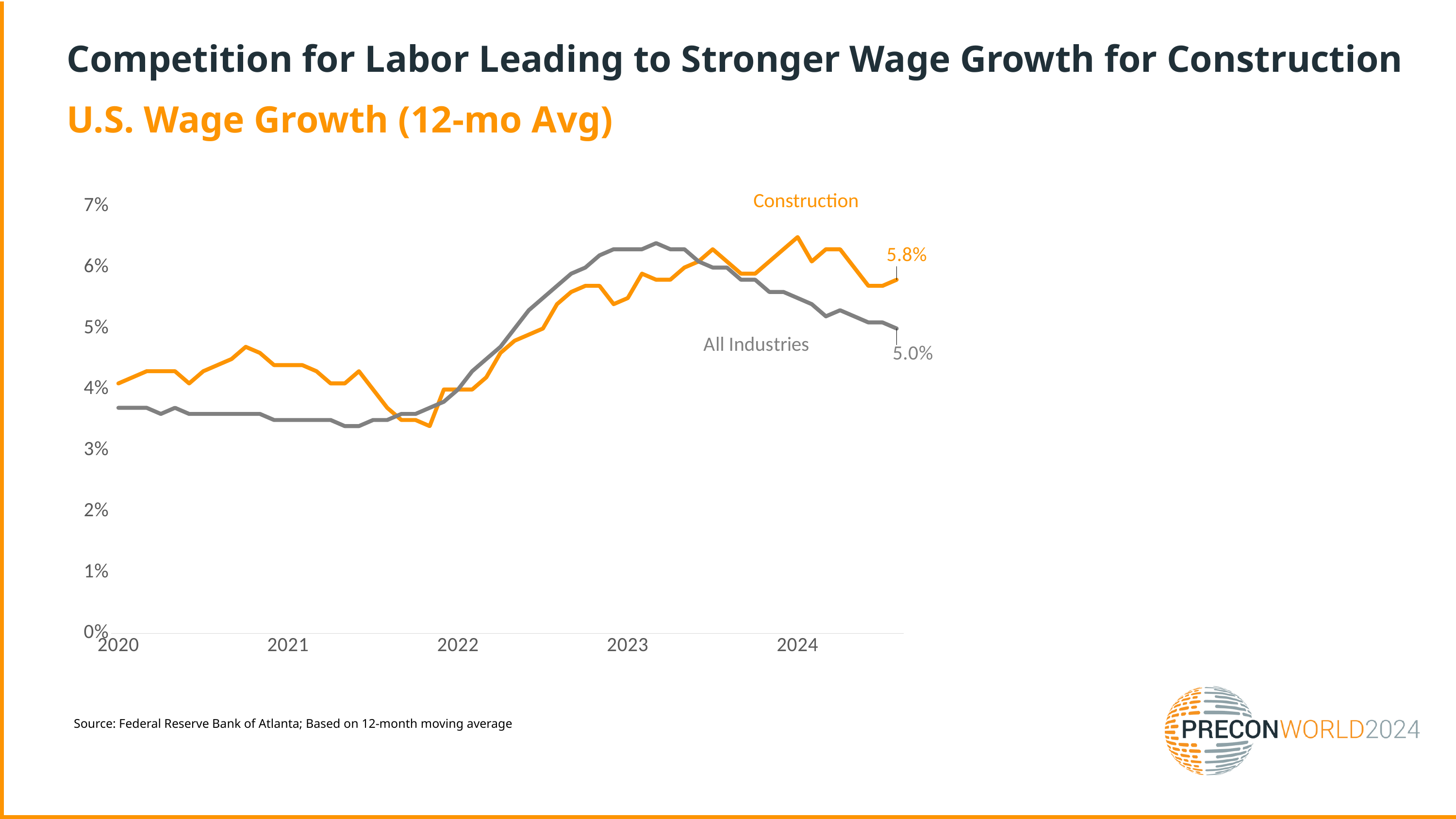
How many series are plotted on the chart? 2 Is the All Industries value at the start of 2020 greater or less than 4%? less What is the difference between the latest Construction value and the latest All Industries value? 0.8% What is the latest value shown for the All Industries series? 5.0% What type of chart is shown on the slide? Line chart Is the latest Construction value greater or less than 5%? greater Does the All Industries series rise or fall from the start of 2023 to the end of the chart? Fall At the end of the series, which is higher: Construction or All Industries? Construction What is the title of the chart? U.S. Wage Growth (12-mo Avg) What is the latest value shown for the Construction series? 5.8% Is the Construction value at the start of 2020 greater or less than 5%? less What colour is the Construction line? Orange